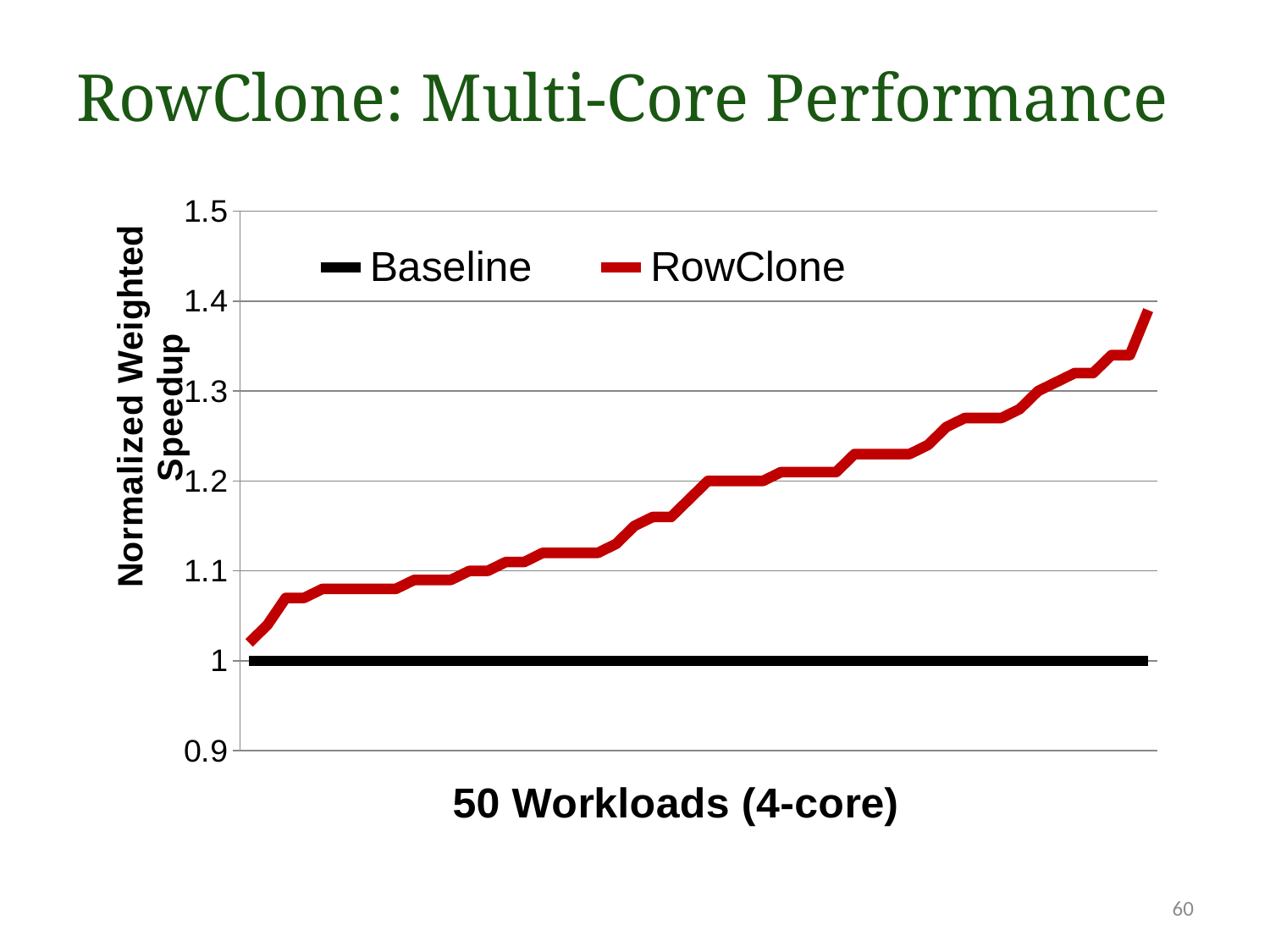
Is the Baseline value greater or less than 1.1? less Is the highest RowClone value greater or less than 1.3? greater How many series does the legend list? 2 Is the highest RowClone value greater or less than 1.5? less What is the normalized weighted speedup of the Baseline series? 1 What are the two series named in the legend? Baseline and RowClone Which series has the higher normalized weighted speedup across the workloads, Baseline or RowClone? RowClone How many workloads are plotted along the x axis? 50 What is the y-axis title of the chart? Normalized Weighted Speedup What kind of chart is shown on the slide? line chart Does the RowClone series rise or fall from left to right along the x axis? rise